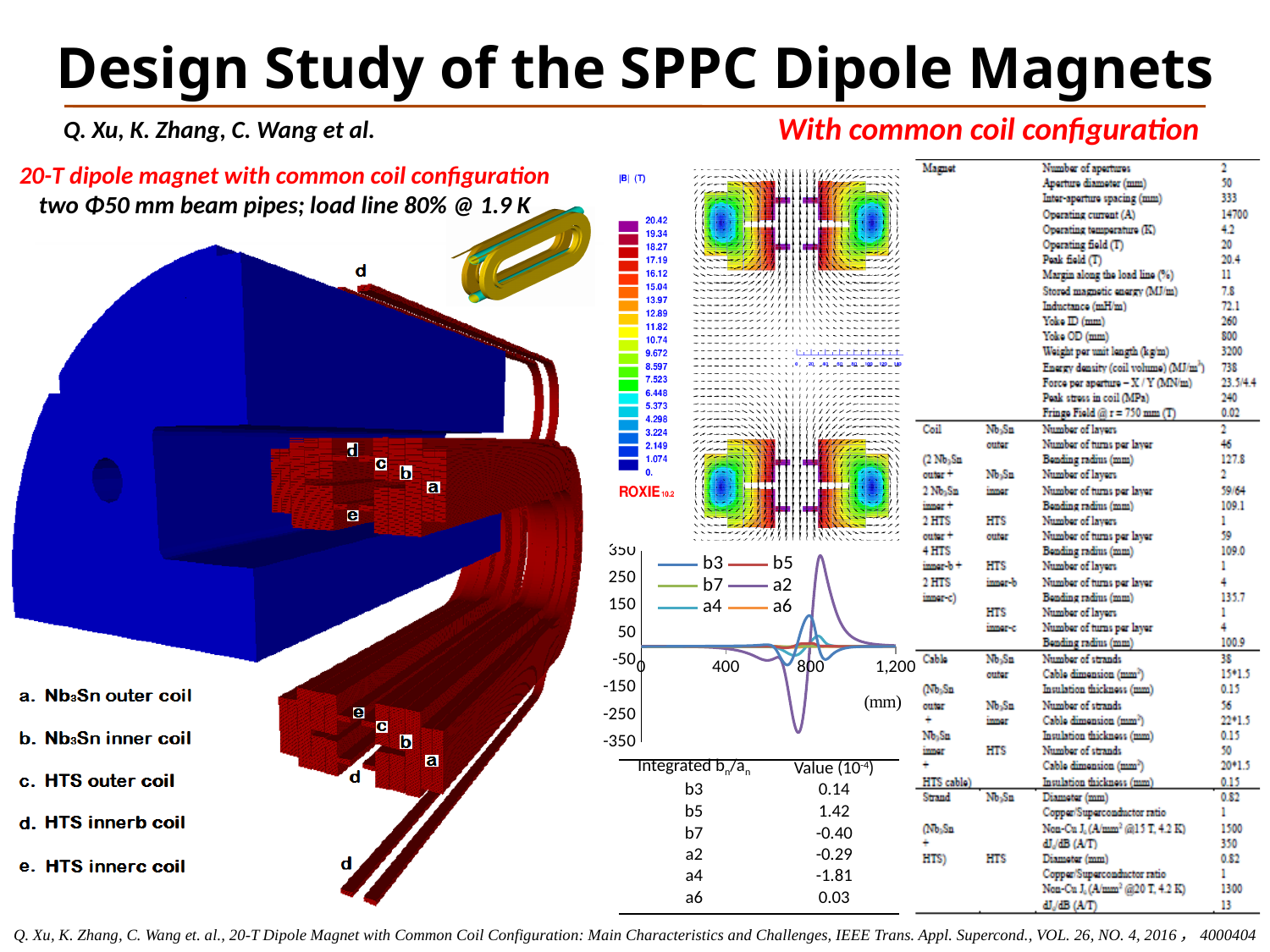
In the line chart, is the peak value of series a4 greater or less than 150? less What is the highest tick value shown on the x axis of the line chart? 1,200 What unit is given for the x axis of the line chart? mm Which series in the line chart reaches the highest peak value? a2 In the line chart, which series has a larger peak amplitude, a2 or a4? a2 What kind of chart is shown on the slide (the plot with series b3, b5, b7, a2, a4, a6)? line chart In the line chart, is the peak value of series a2 greater or less than 250? greater Which series in the line chart reaches the lowest (most negative) value? a2 In the line chart, is the minimum value of series a2 greater or less than -250? less How many series does the legend of the line chart list? 6